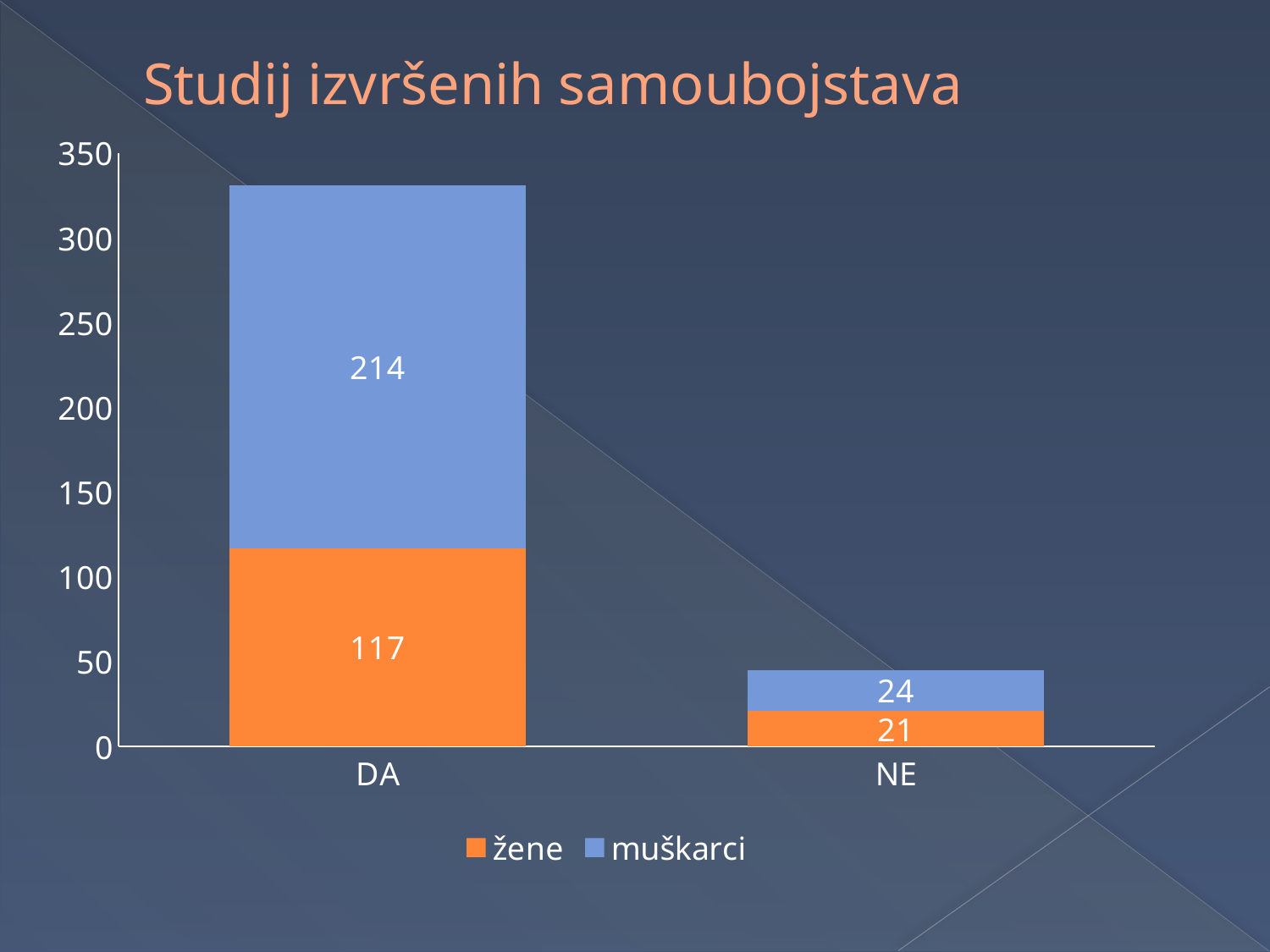
What is the value for muškarci in the DA category? 214 Which category has the higher value for muškarci, DA or NE? DA How many categories are shown on the x axis? 2 Which category has the lowest value for žene? NE What is the value for žene in the DA category? 117 What is the value for žene in the NE category? 21 What is the difference between the muškarci value and the žene value in the DA category? 97 What is the value for muškarci in the NE category? 24 What is the total of the stacked bar for NE? 45 How many series does the legend list? 2 What type of chart is shown on the slide? Stacked bar chart What is the total of the stacked bar for DA? 331